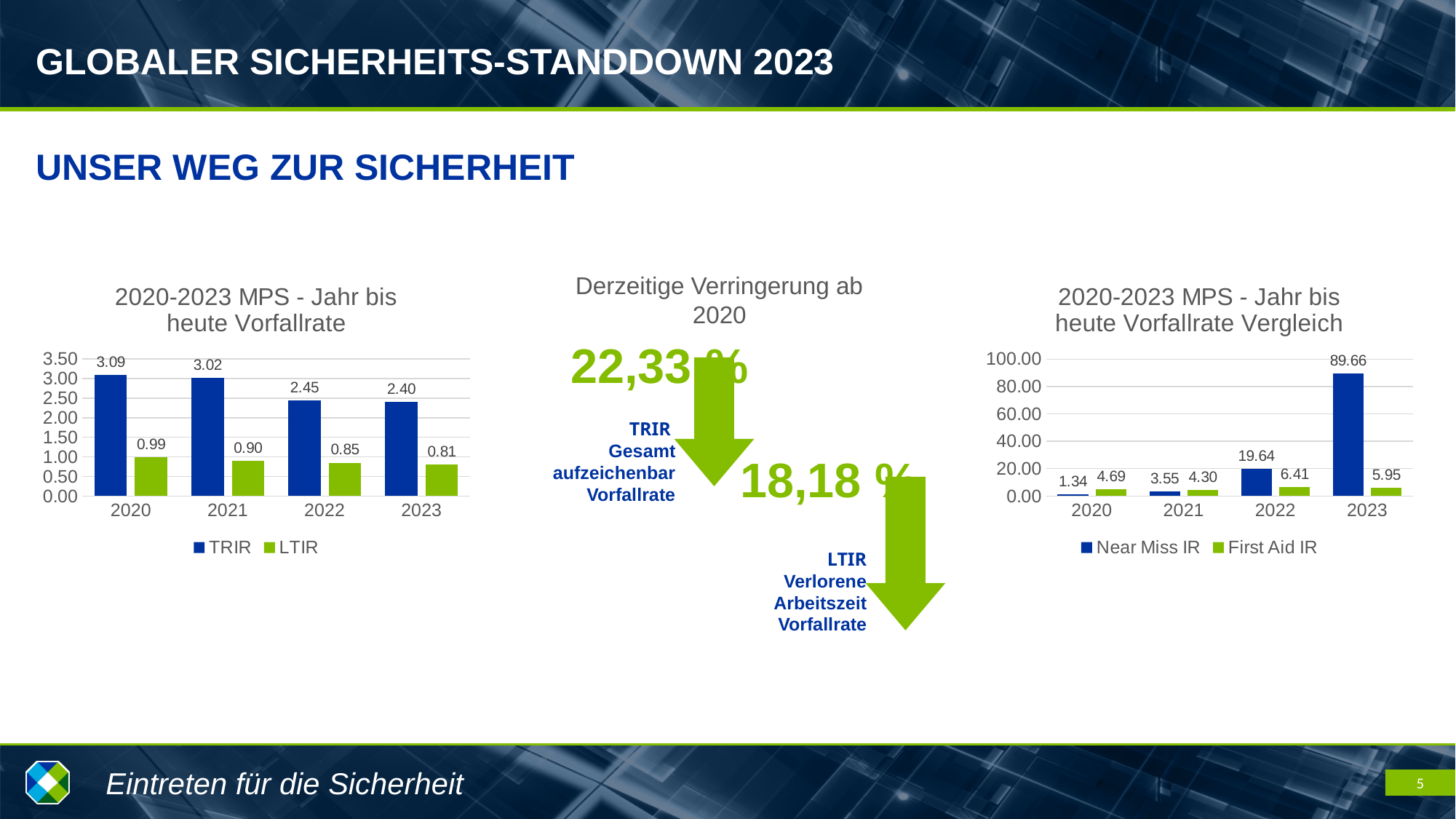
In the left chart '2020-2023 MPS - Jahr bis heute Vorfallrate', what is the TRIR value for 2020? 3.09 In the right chart '2020-2023 MPS - Jahr bis heute Vorfallrate Vergleich', what is the Near Miss IR value for 2023? 89.66 In the left chart '2020-2023 MPS - Jahr bis heute Vorfallrate', do the LTIR values rise or fall from 2020 to 2023? fall In the right chart '2020-2023 MPS - Jahr bis heute Vorfallrate Vergleich', which is larger for 2020: Near Miss IR or First Aid IR? First Aid IR In the left chart '2020-2023 MPS - Jahr bis heute Vorfallrate', what is the difference between the TRIR values for 2020 and 2023? 0.69 In the right chart '2020-2023 MPS - Jahr bis heute Vorfallrate Vergleich', what is the First Aid IR value for 2021? 4.30 In the left chart '2020-2023 MPS - Jahr bis heute Vorfallrate', what is the LTIR value for 2023? 0.81 What kind of chart is the right chart '2020-2023 MPS - Jahr bis heute Vorfallrate Vergleich'? bar chart In the left chart '2020-2023 MPS - Jahr bis heute Vorfallrate', which year has the lowest TRIR value? 2023 In the left chart '2020-2023 MPS - Jahr bis heute Vorfallrate', how many series does the legend list? 2 In the right chart '2020-2023 MPS - Jahr bis heute Vorfallrate Vergleich', how many years are shown on the x axis? 4 In the right chart '2020-2023 MPS - Jahr bis heute Vorfallrate Vergleich', which year has the highest Near Miss IR value? 2023